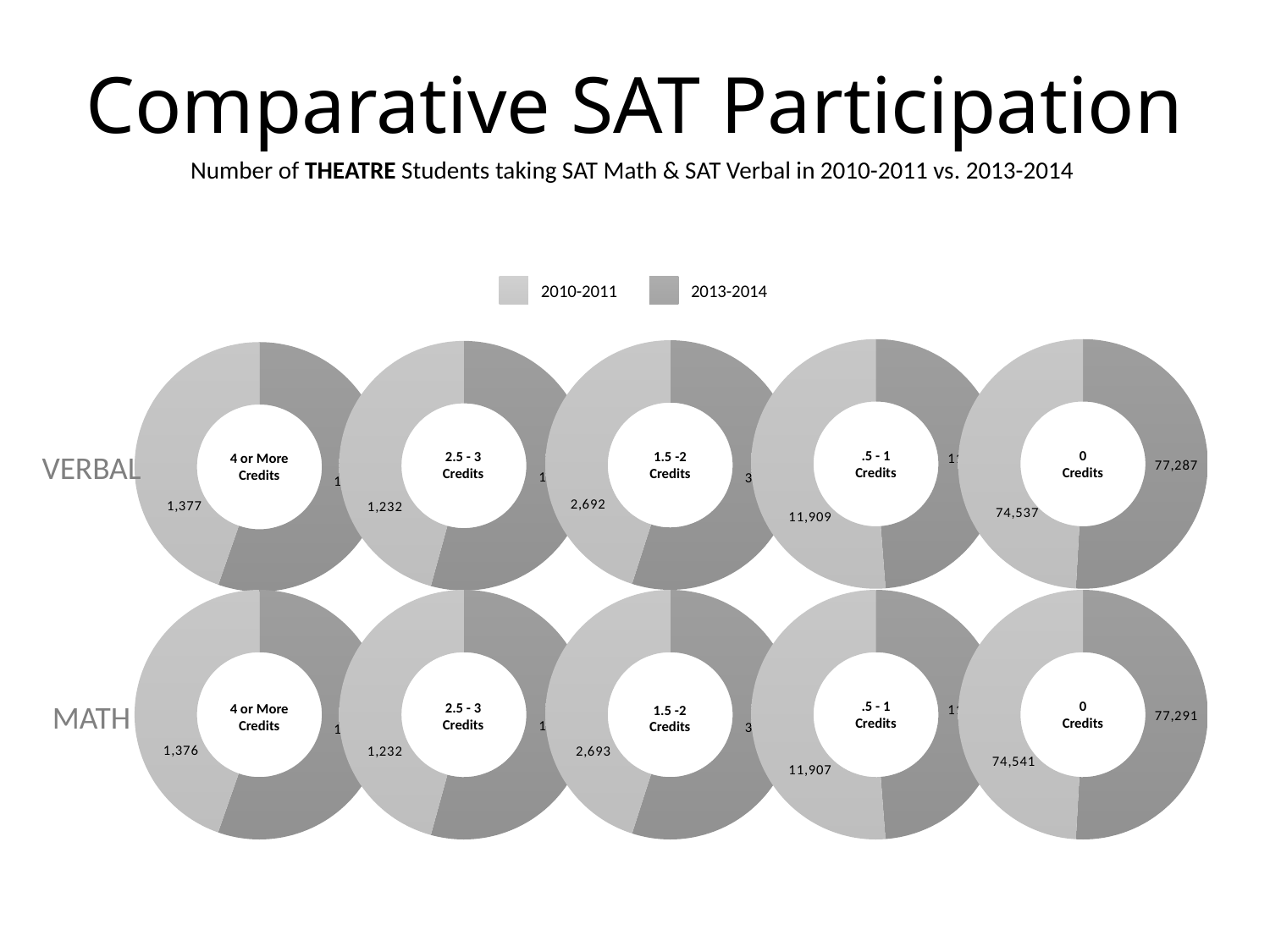
What kind of chart is used on this slide? Donut (pie) chart Which credit category in the MATH row has the lowest 2010-2011 value? 2.5 - 3 Credits In the VERBAL row, what is the 2010-2011 value in the '.5 - 1 Credits' donut chart? 11,909 Which credit category in the VERBAL row has the highest 2010-2011 value? 0 Credits In the VERBAL row, what is the 2013-2014 value in the '0 Credits' donut chart? 77,287 How many series does the legend list? 2 In the VERBAL row '0 Credits' donut chart, what is the difference between the 2013-2014 and 2010-2011 values? 2,750 In the MATH row, what is the 2010-2011 value in the '1.5 -2 Credits' donut chart? 2,693 In the MATH row '0 Credits' donut chart, which series has the larger value, 2010-2011 or 2013-2014? 2013-2014 In the VERBAL row, what is the 2010-2011 value in the '4 or More Credits' donut chart? 1,377 In the MATH row, what is the 2010-2011 value in the '0 Credits' donut chart? 74,541 In the MATH row, what is the 2013-2014 value in the '0 Credits' donut chart? 77,291